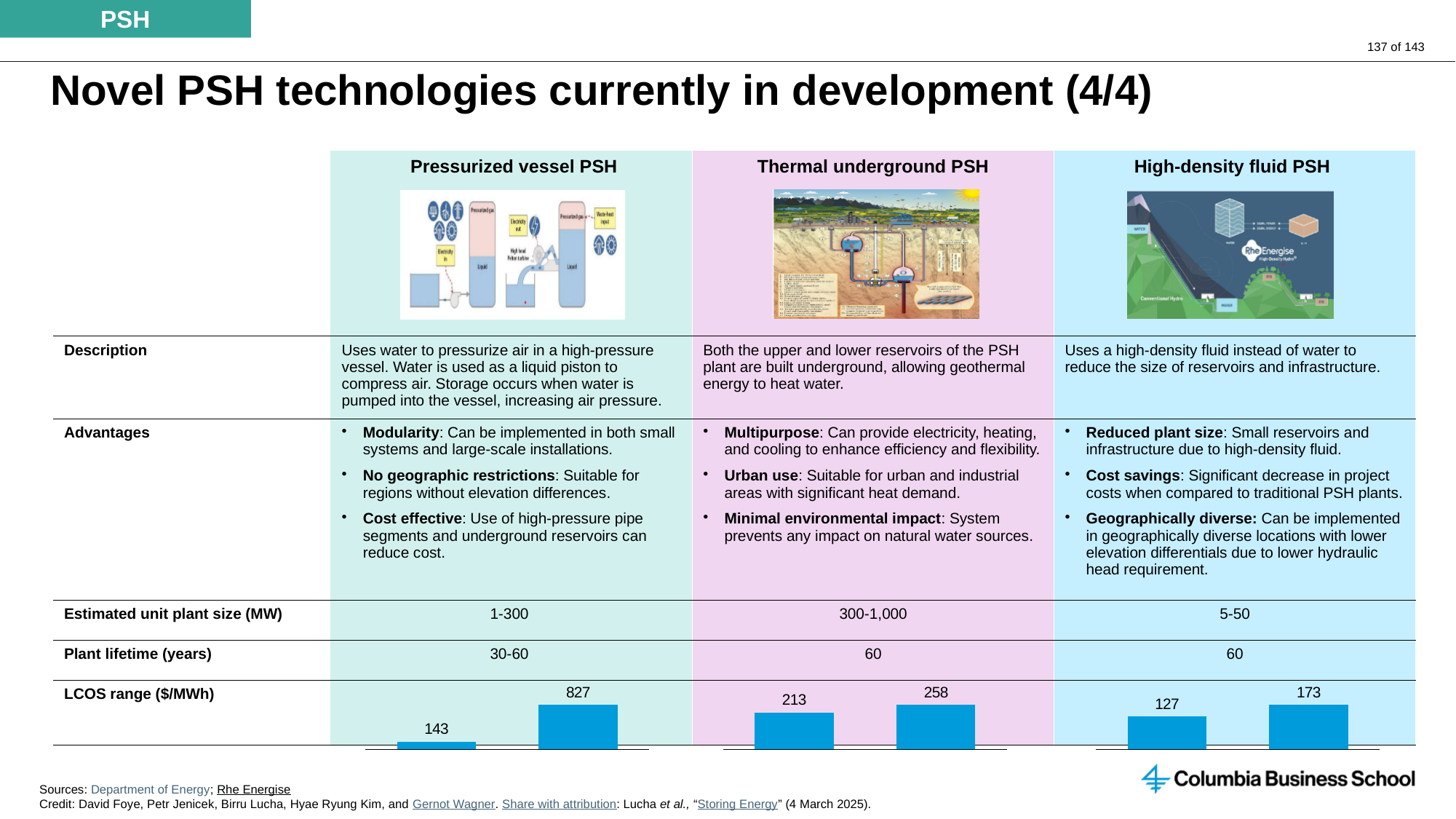
Across the three LCOS range charts, which technology has the highest plotted value? Pressurized vessel PSH In the LCOS range chart for Pressurized vessel PSH, what is the value of the right-hand (higher) bar? 827 In the LCOS range chart for Thermal underground PSH, what is the value of the left-hand bar? 213 In the LCOS range chart for High-density fluid PSH, what is the difference between the two bars? 46 In the LCOS range chart for Thermal underground PSH, what is the difference between the two bars? 45 In the LCOS range chart for Pressurized vessel PSH, what is the difference between the two bars? 684 What kind of chart is used to show the LCOS range for each technology? Bar chart Across the three LCOS range charts, which technology has the lowest plotted value? High-density fluid PSH In the LCOS range chart for Pressurized vessel PSH, what is the value of the left-hand (lower) bar? 143 In the LCOS range chart for High-density fluid PSH, what is the value of the right-hand bar? 173 In the LCOS range chart for Thermal underground PSH, what is the value of the right-hand bar? 258 In the LCOS range chart for High-density fluid PSH, what is the value of the left-hand bar? 127